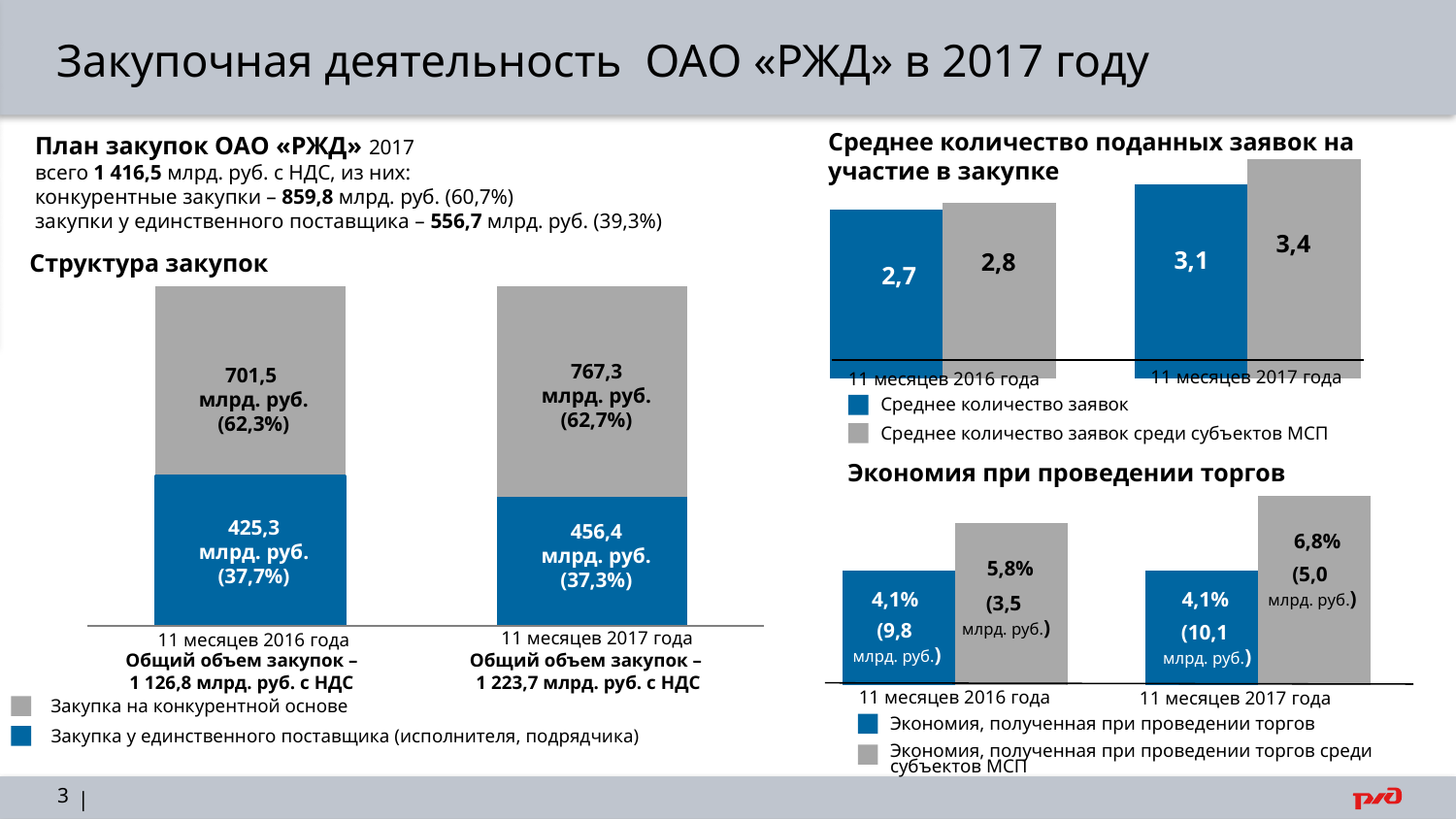
How many series does the legend of the 'Структура закупок' chart list? 2 How many categories are shown on the x axis of the 'Экономия при проведении торгов' chart? 2 In the 'Структура закупок' chart, by how much did purchases on a competitive basis increase from 11 месяцев 2016 года to 11 месяцев 2017 года? 65,8 млрд. руб. In the 'Структура закупок' chart, what is the total volume of purchases for 11 месяцев 2017 года? 1 223,7 млрд. руб. с НДС In the 'Экономия при проведении торгов' chart, which is larger: savings among SME entities for 11 месяцев 2016 года or for 11 месяцев 2017 года? 11 месяцев 2017 года (6,8%) In the 'Структура закупок' chart, what is the value of purchases from a single supplier for 11 месяцев 2017 года? 456,4 млрд. руб. (37,3%) In the 'Среднее количество поданных заявок на участие в закупке' chart, do the values rise or fall from 2016 to 2017? Rise In the 'Среднее количество поданных заявок на участие в закупке' chart, which bar has the highest value? Среднее количество заявок среди субъектов МСП, 11 месяцев 2017 года (3,4) In the 'Структура закупок' chart, what is the value of purchases on a competitive basis for 11 месяцев 2016 года? 701,5 млрд. руб. (62,3%) In the 'Среднее количество поданных заявок на участие в закупке' chart, what is the average number of applications among SME entities for 11 месяцев 2017 года? 3,4 In the 'Экономия при проведении торгов' chart, what is the savings percentage among SME entities for 11 месяцев 2016 года? 5,8% What kind of chart is the 'Структура закупок' chart? Stacked bar chart